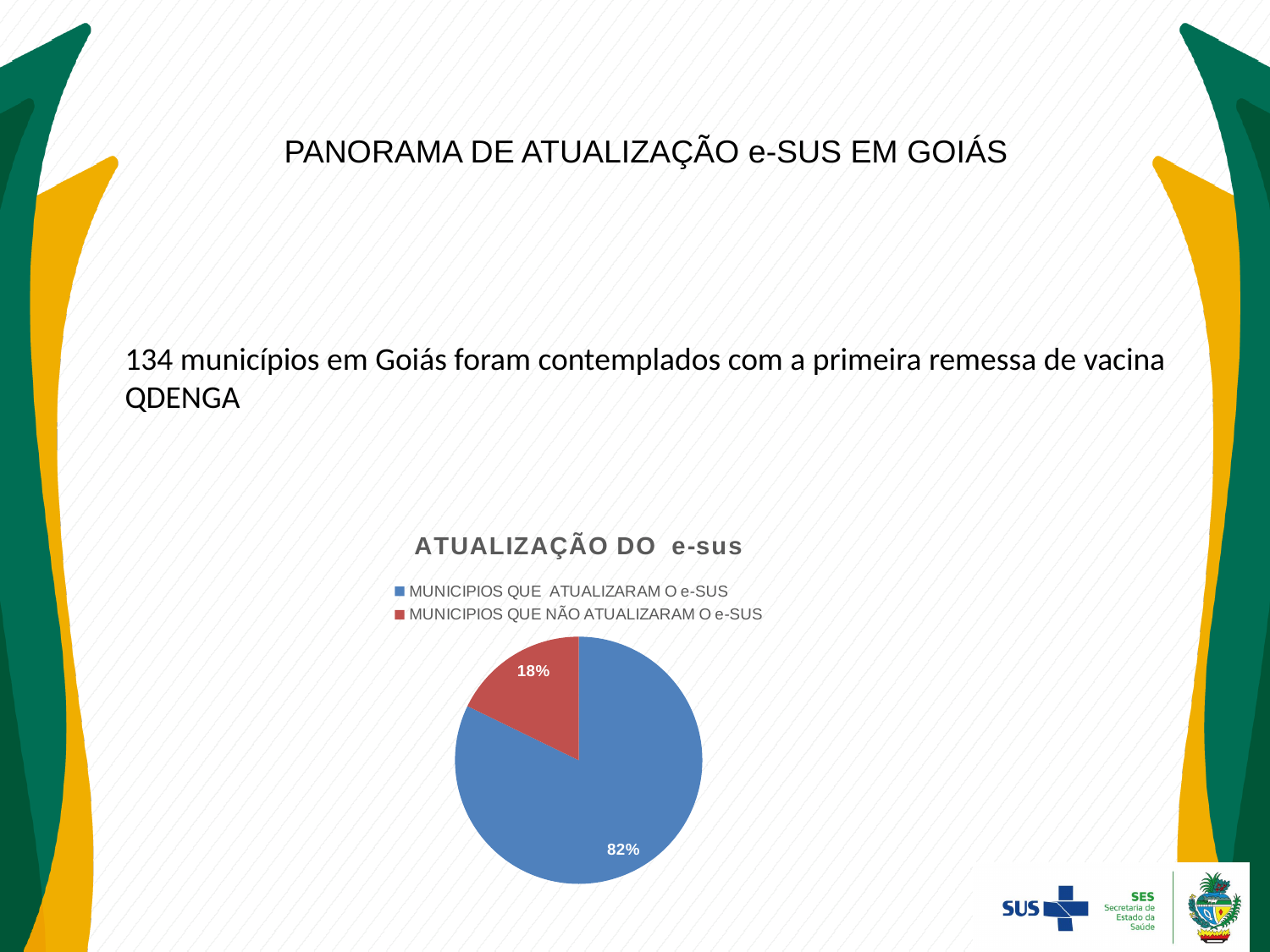
What is the difference in percentage points between the slice for municipalities that updated e-SUS and the slice for those that did not? 64 How many entries does the legend list? 2 Which category has the smallest slice of the pie? MUNICIPIOS QUE NÃO ATUALIZARAM O e-SUS What share of the pie is labelled for MUNICIPIOS QUE NÃO ATUALIZARAM O e-SUS? 18% Which is larger: the slice for MUNICIPIOS QUE ATUALIZARAM O e-SUS or the slice for MUNICIPIOS QUE NÃO ATUALIZARAM O e-SUS? MUNICIPIOS QUE ATUALIZARAM O e-SUS Which category has the largest slice of the pie? MUNICIPIOS QUE ATUALIZARAM O e-SUS What share of the pie is labelled for MUNICIPIOS QUE ATUALIZARAM O e-SUS? 82% What is the chart's title? ATUALIZAÇÃO DO e-sus What kind of chart is shown on the slide? pie chart How many categories does the pie chart show? 2 What colour is the slice for MUNICIPIOS QUE NÃO ATUALIZARAM O e-SUS? red